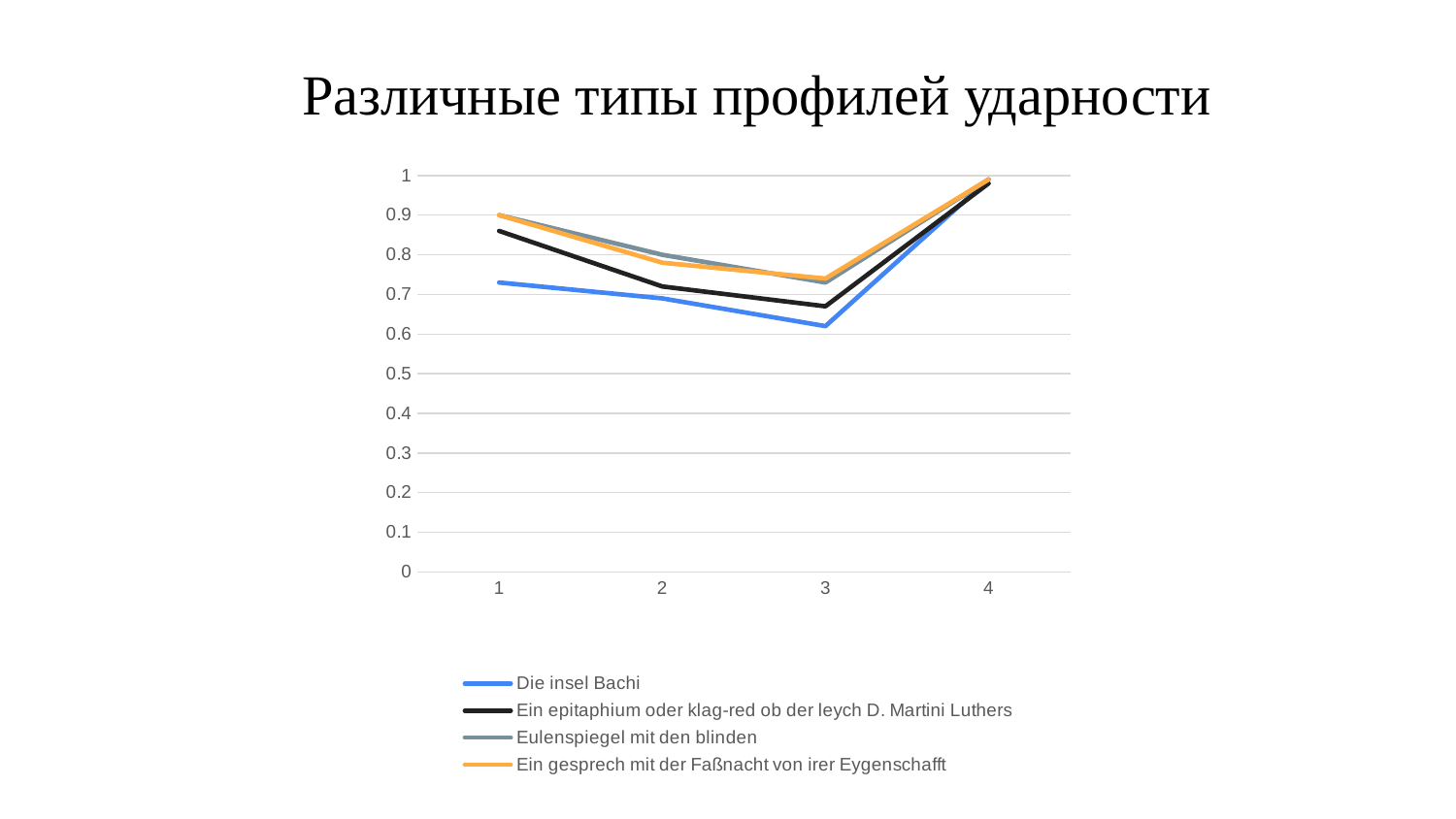
Is the value for Ein gesprech mit der Faßnacht von irer Eygenschafft at point 3 greater or less than 0.7? greater What colour is the line for Die insel Bachi? blue Is the value for Die insel Bachi at point 3 greater or less than 0.7? less What kind of chart is shown on the slide? line chart At point 1, which is higher: Die insel Bachi or Ein epitaphium oder klag-red ob der leych D. Martini Luthers? Ein epitaphium oder klag-red ob der leych D. Martini Luthers At which x-axis point does Die insel Bachi reach its lowest value? 3 At which x-axis point does Die insel Bachi reach its highest value? 4 Is the value for Die insel Bachi at point 1 greater or less than 0.8? less How many series does the legend list? 4 How many points are there along the x axis? 4 Do the values for all series rise or fall from point 3 to point 4? rise